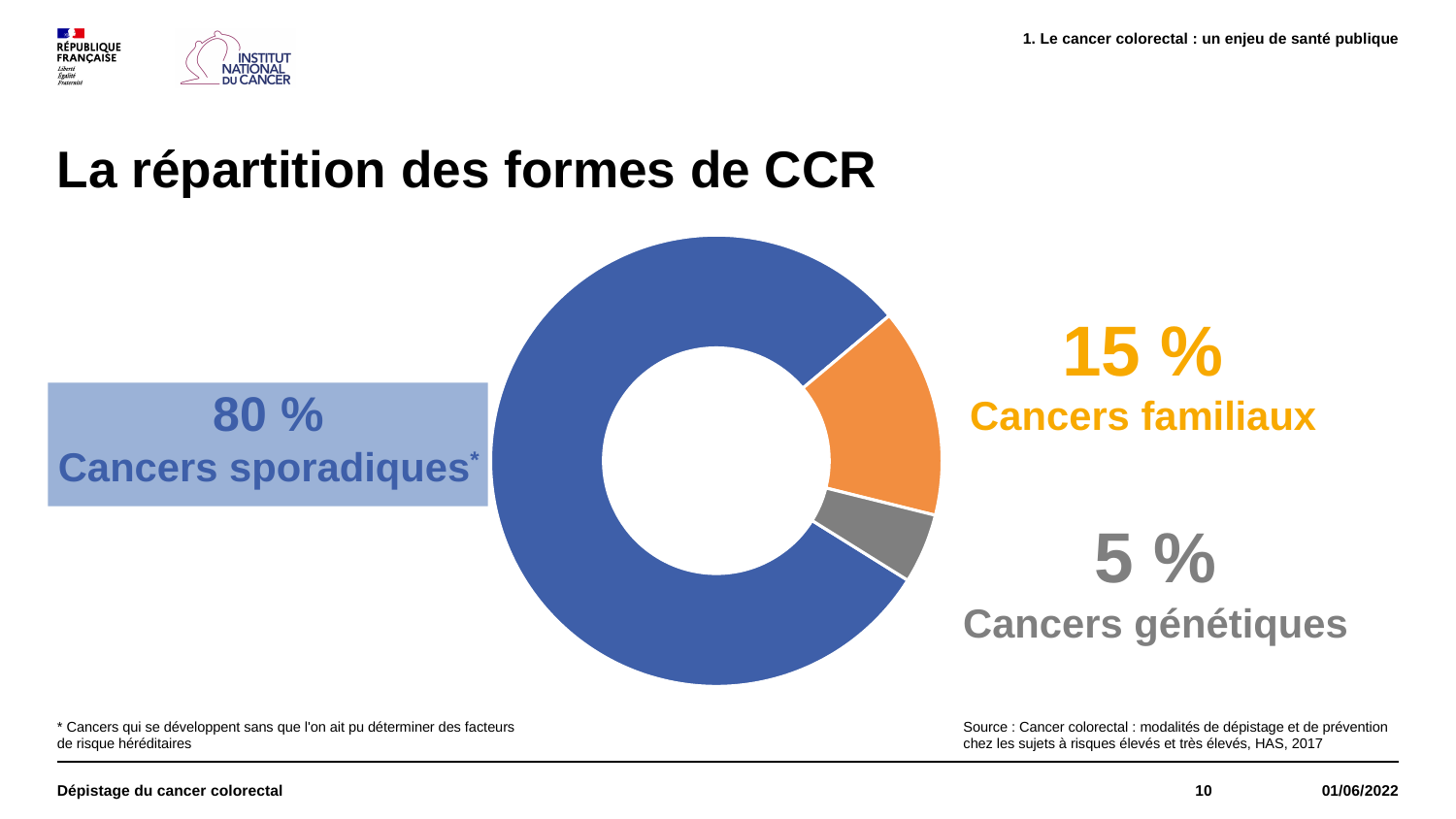
Which category has the smallest share of the donut chart? Cancers génétiques What is the difference in percentage points between Cancers familiaux and Cancers génétiques? 10 % What is the difference in percentage points between Cancers sporadiques and Cancers familiaux? 65 % What share of CCR forms do Cancers sporadiques represent? 80 % Which is larger, the share of Cancers familiaux or the share of Cancers génétiques? Cancers familiaux What share of CCR forms do Cancers génétiques represent? 5 % How many categories are shown in the donut chart? 3 What is the title of the chart on the slide? La répartition des formes de CCR What share of CCR forms do Cancers familiaux represent? 15 % What colour is the slice representing Cancers familiaux? Orange What kind of chart is shown on the slide? Donut (pie) chart Which category has the largest share of the donut chart? Cancers sporadiques